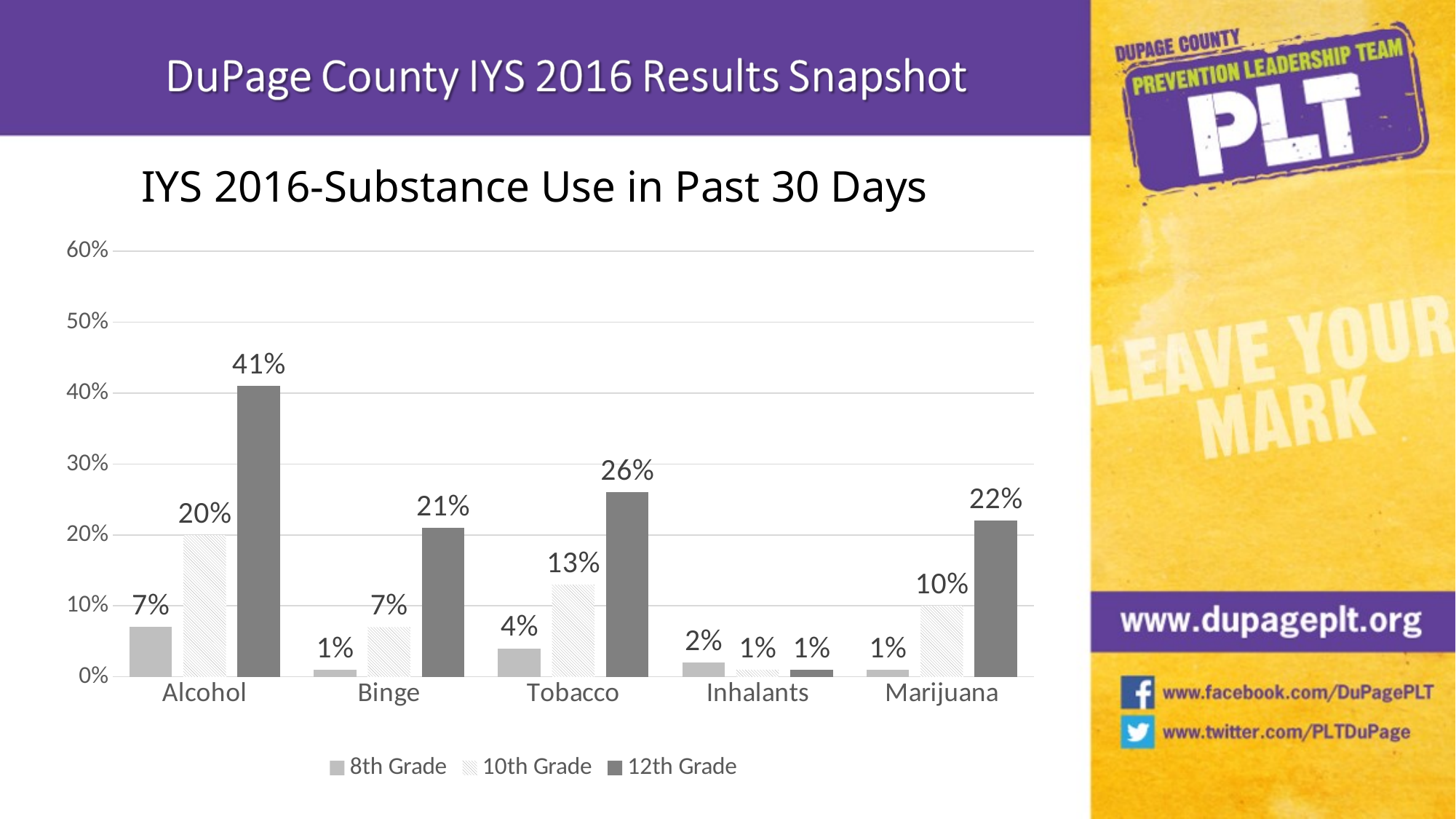
What is the 12th Grade value for Alcohol? 41% Which is larger: the 12th Grade value for Marijuana or the 12th Grade value for Binge? Marijuana What is the 10th Grade value for Tobacco? 13% Which substance has the highest 12th Grade value? Alcohol What kind of chart is shown on the slide? bar chart How many substance categories are shown on the x axis? 5 How many series does the legend list? 3 Which substance has the lowest 12th Grade value? Inhalants Is the 12th Grade value for Tobacco greater or less than 20%? greater What is the difference between the 12th Grade and 8th Grade values for Alcohol? 34% What is the 8th Grade value for Marijuana? 1% What is the title of the chart? IYS 2016-Substance Use in Past 30 Days